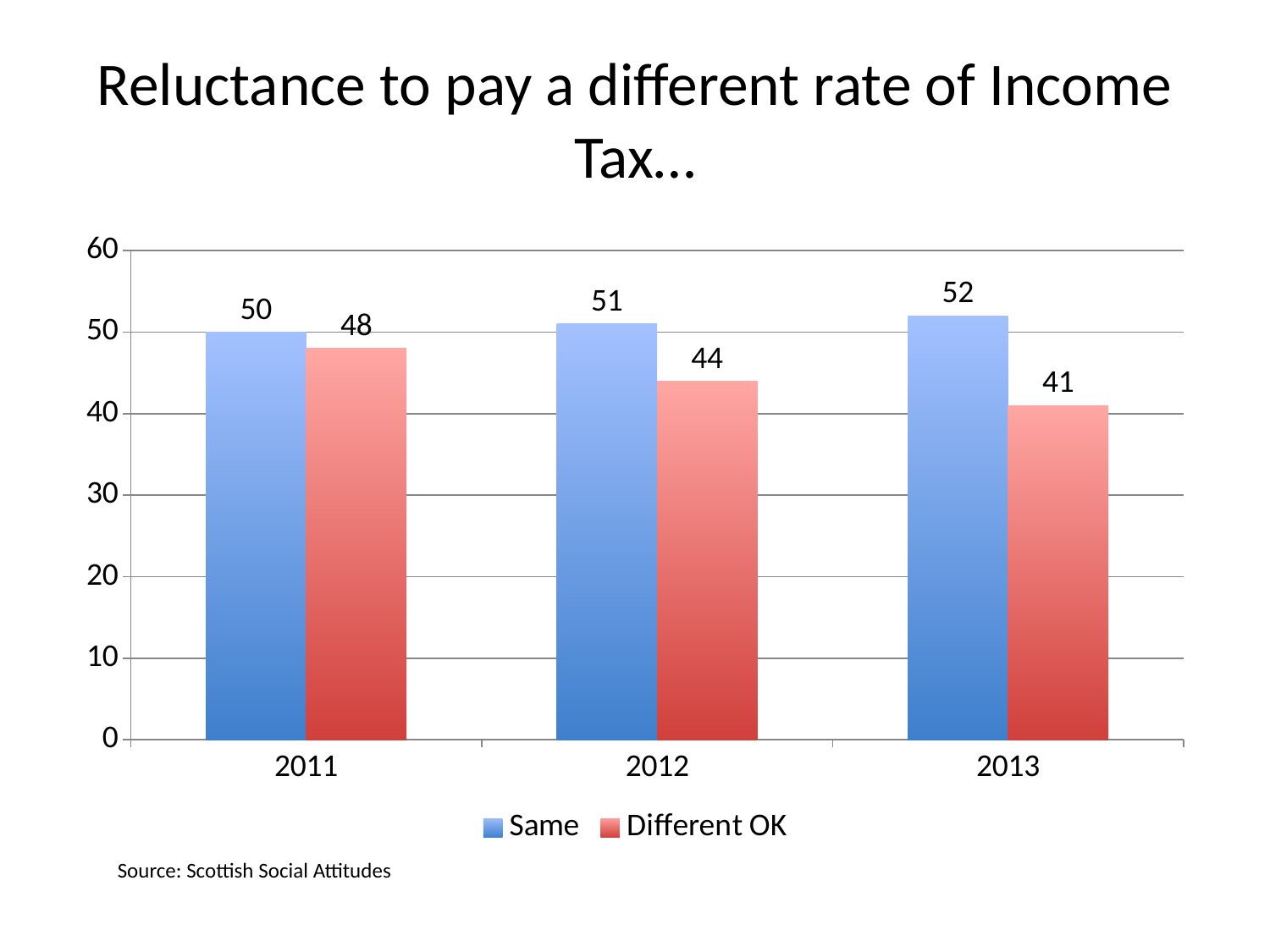
Does the Different OK series rise or fall from 2011 to 2013? Fall What is the difference between Same and Different OK in 2013? 11 In which year is the Same series highest? 2013 What is the value for Same in 2011? 50 In which year is the Different OK series lowest? 2013 How many series does the legend list? 2 How many years are shown on the x axis? 3 What is the source cited below the chart? Scottish Social Attitudes Which is larger in 2012, Same or Different OK? Same What is the value for Different OK in 2013? 41 What is the value for Different OK in 2012? 44 What kind of chart is shown? Bar chart